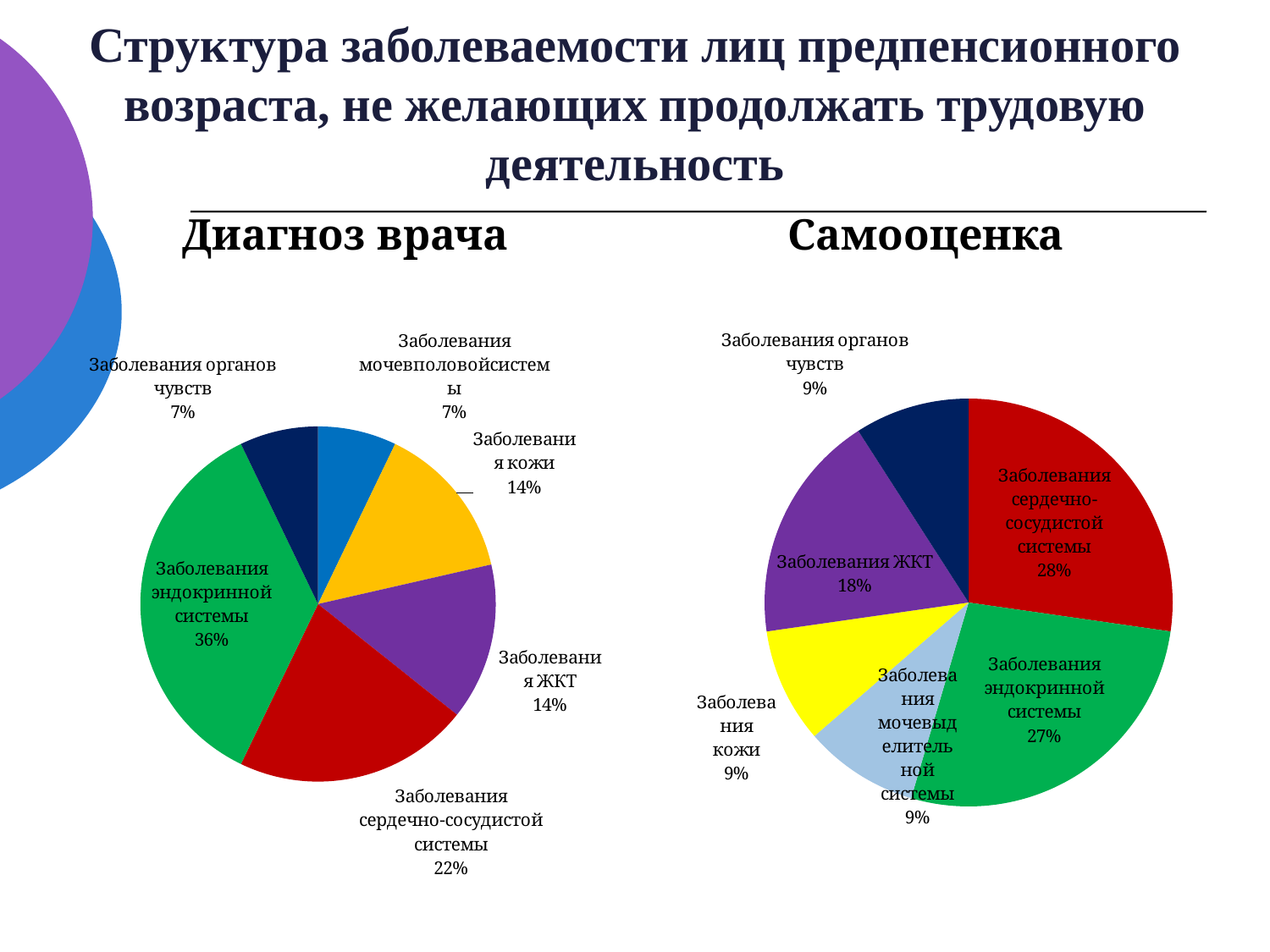
Which is larger: the share of Заболевания ЖКТ in the "Диагноз врача" chart or in the "Самооценка" chart? Самооценка In the "Диагноз врача" chart, what share is shown for Заболевания эндокринной системы? 36% In the "Самооценка" chart, what share is shown for Заболевания ЖКТ? 18% In the "Диагноз врача" chart, how many slices does the pie have? 6 In the "Самооценка" chart, which category has the largest share? Заболевания сердечно-сосудистой системы In the "Самооценка" chart, what is the combined share of Заболевания кожи and Заболевания органов чувств? 18% In the "Диагноз врача" chart, which category has the largest share? Заболевания эндокринной системы In the "Диагноз врача" chart, what share is shown for Заболевания сердечно-сосудистой системы? 22% In the "Самооценка" chart, how many slices does the pie have? 6 In the "Диагноз врача" chart, what is the difference between the shares of Заболевания эндокринной системы and Заболевания сердечно-сосудистой системы? 14% What type of chart is used for "Самооценка"? Pie chart In the "Самооценка" chart, what share is shown for Заболевания сердечно-сосудистой системы? 28%